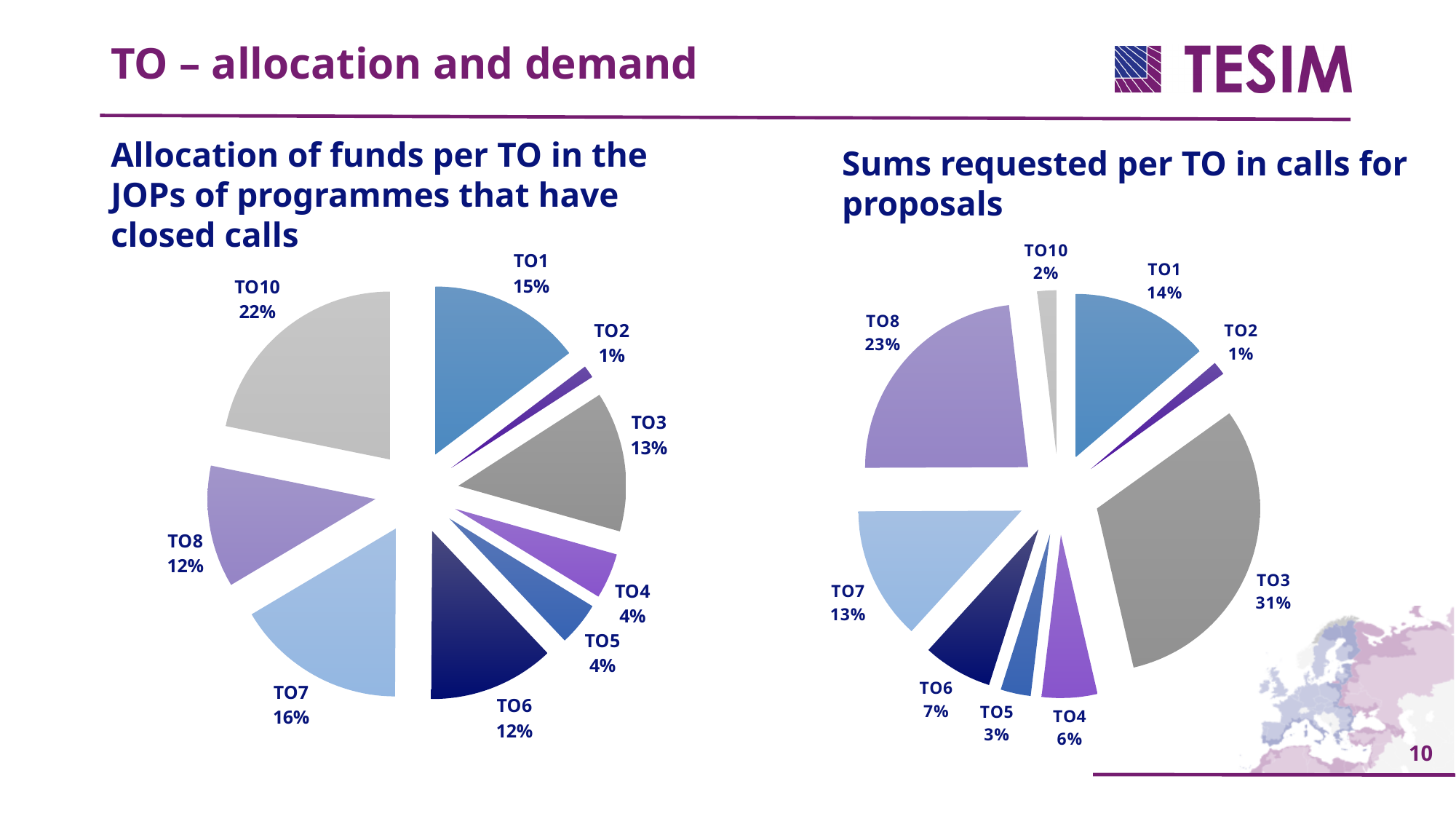
In the left pie chart (Allocation of funds per TO), what share does TO6 have? 12% In the right pie chart (Sums requested per TO), what share does TO3 have? 31% In the right pie chart (Sums requested per TO), what is the difference in percentage points between TO3 and TO1? 17 What is the title of the right chart? Sums requested per TO in calls for proposals What type of chart is used on the right (Sums requested per TO)? Pie chart In the right pie chart (Sums requested per TO), what share does TO10 have? 2% In the left pie chart (Allocation of funds per TO), what is the difference in percentage points between TO7 and TO8? 4 How many slices does the left pie chart (Allocation of funds per TO) have? 9 In the left pie chart (Allocation of funds per TO), what share does TO10 have? 22% In the right pie chart (Sums requested per TO), which is larger, the share for TO8 or the share for TO7? TO8 In the right pie chart (Sums requested per TO), which TO has the smallest share? TO2 In the left pie chart (Allocation of funds per TO), which TO has the largest share? TO10